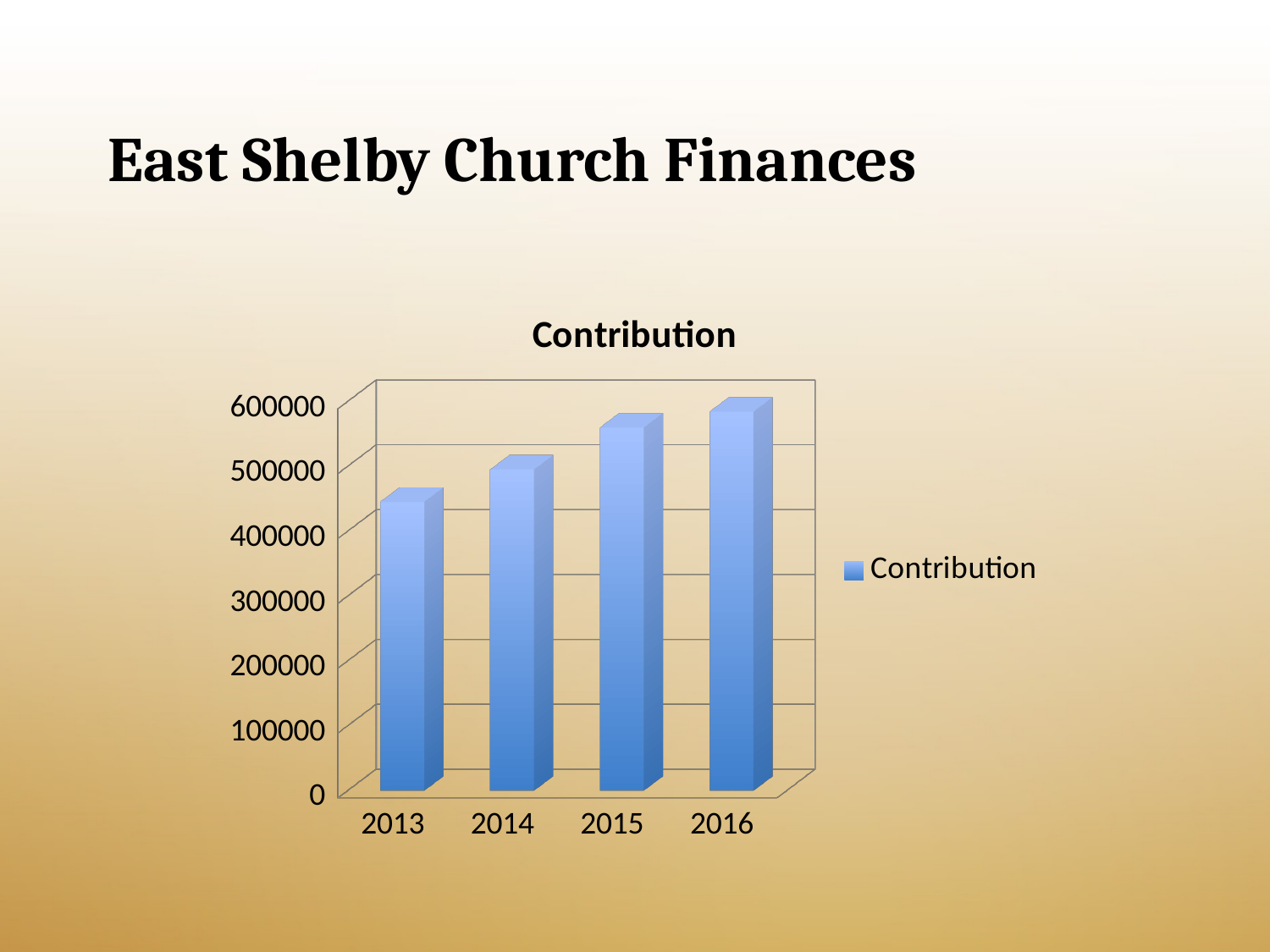
What is the title of the chart? Contribution Is the contribution for 2015 greater or less than 500000? greater What kind of chart is shown on the slide? bar chart Is the contribution for 2013 greater or less than 400000? greater How many years are shown on the x axis of the chart? 4 Which year has the highest contribution? 2016 Which year has the lowest contribution? 2013 How many series does the chart's legend list? 1 Do contributions rise or fall from 2013 to 2016? rise Is the contribution for 2016 greater or less than 400000? greater Which year has the larger contribution, 2013 or 2015? 2015